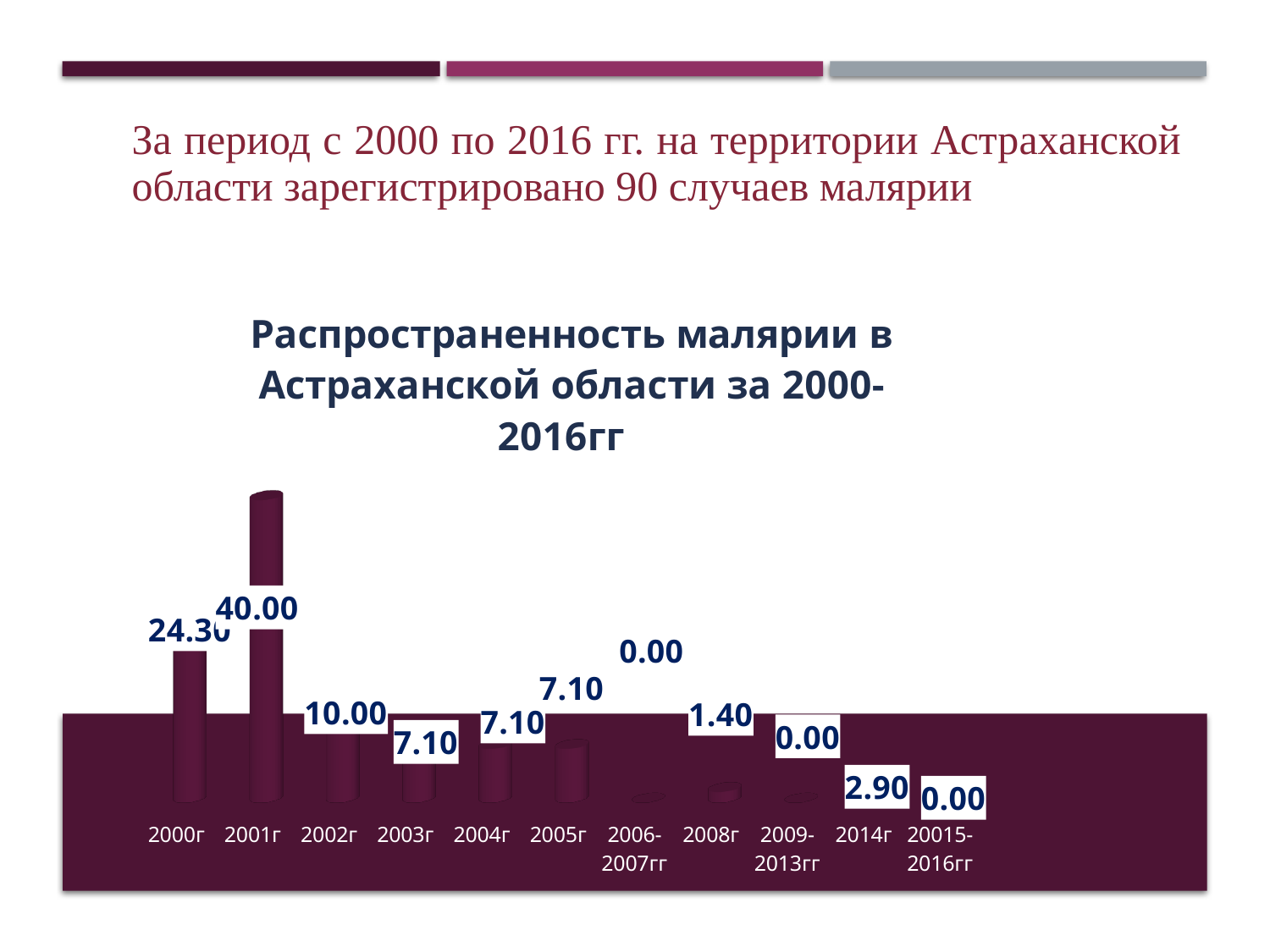
What is the value for 2014г? 2.90 What is the title of the chart? Распространенность малярии в Астраханской области за 2000-2016гг What type of chart is shown on the slide? bar chart How many categories are shown on the x axis? 11 What is the value for 2008г? 1.40 Which is larger, the value for 2002г or the value for 2003г? 2002г What is the value for 2001г? 40.00 What is the difference between the values for 2001г and 2002г? 30.00 What is the difference between the values for 2014г and 2008г? 1.50 What is the value for 2009-2013гг? 0.00 What is the value for 2002г? 10.00 Which category has the highest value? 2001г